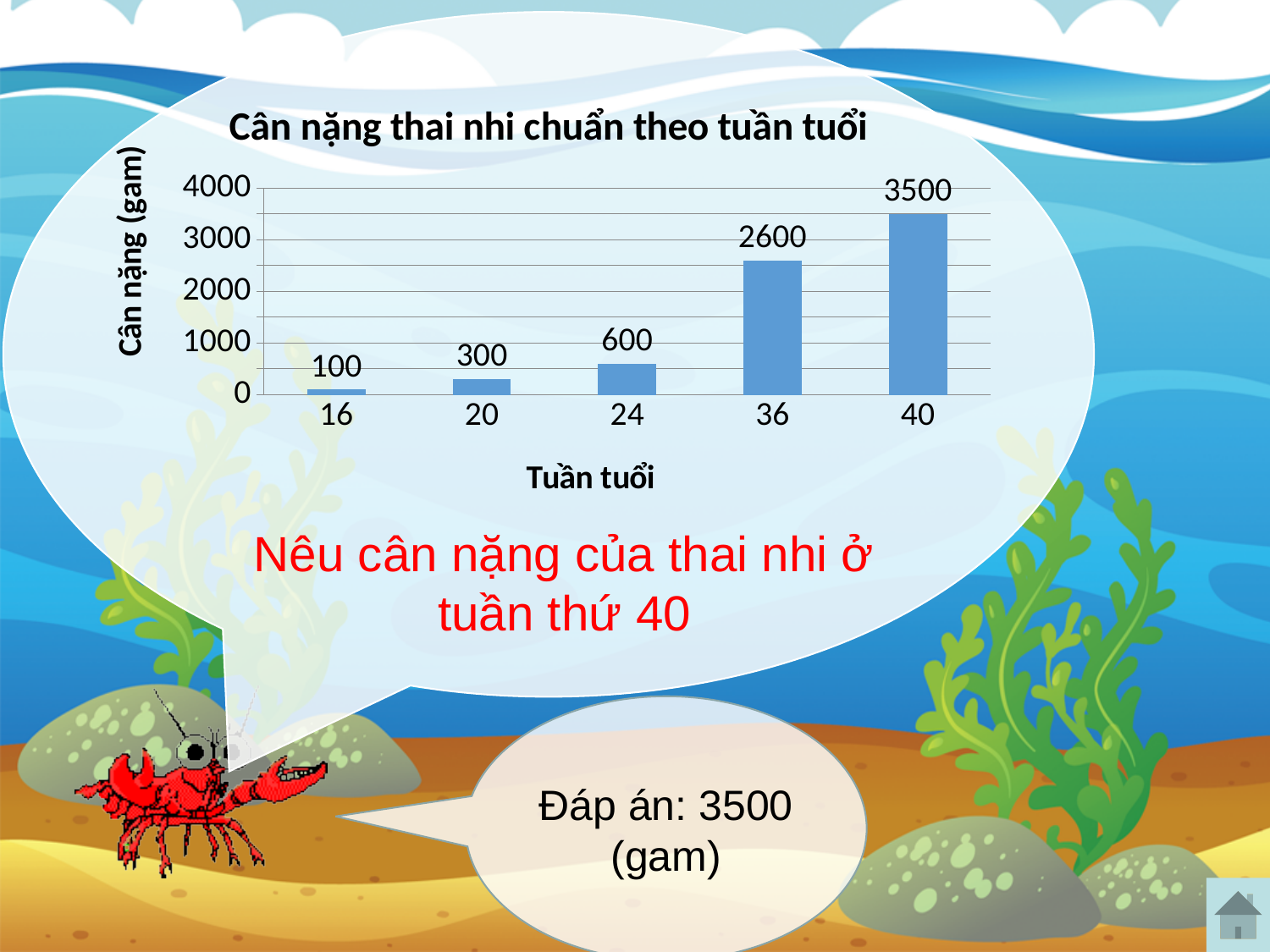
What is the value for week 16 in the chart? 100 What is the title of the chart? Cân nặng thai nhi chuẩn theo tuần tuổi How many weeks (categories) are shown on the x axis of the chart? 5 Which week has the lowest value in the chart? 16 What is the difference between the values for week 40 and week 36? 900 What is the value for week 40 in the chart? 3500 Which is larger, the value for week 36 or the value for week 24? 36 What kind of chart is shown on the slide? bar chart What is the difference between the values for week 24 and week 20? 300 Which week has the highest value in the chart? 40 What is the value for week 24 in the chart? 600 Is the value for week 36 greater or less than 2000? greater